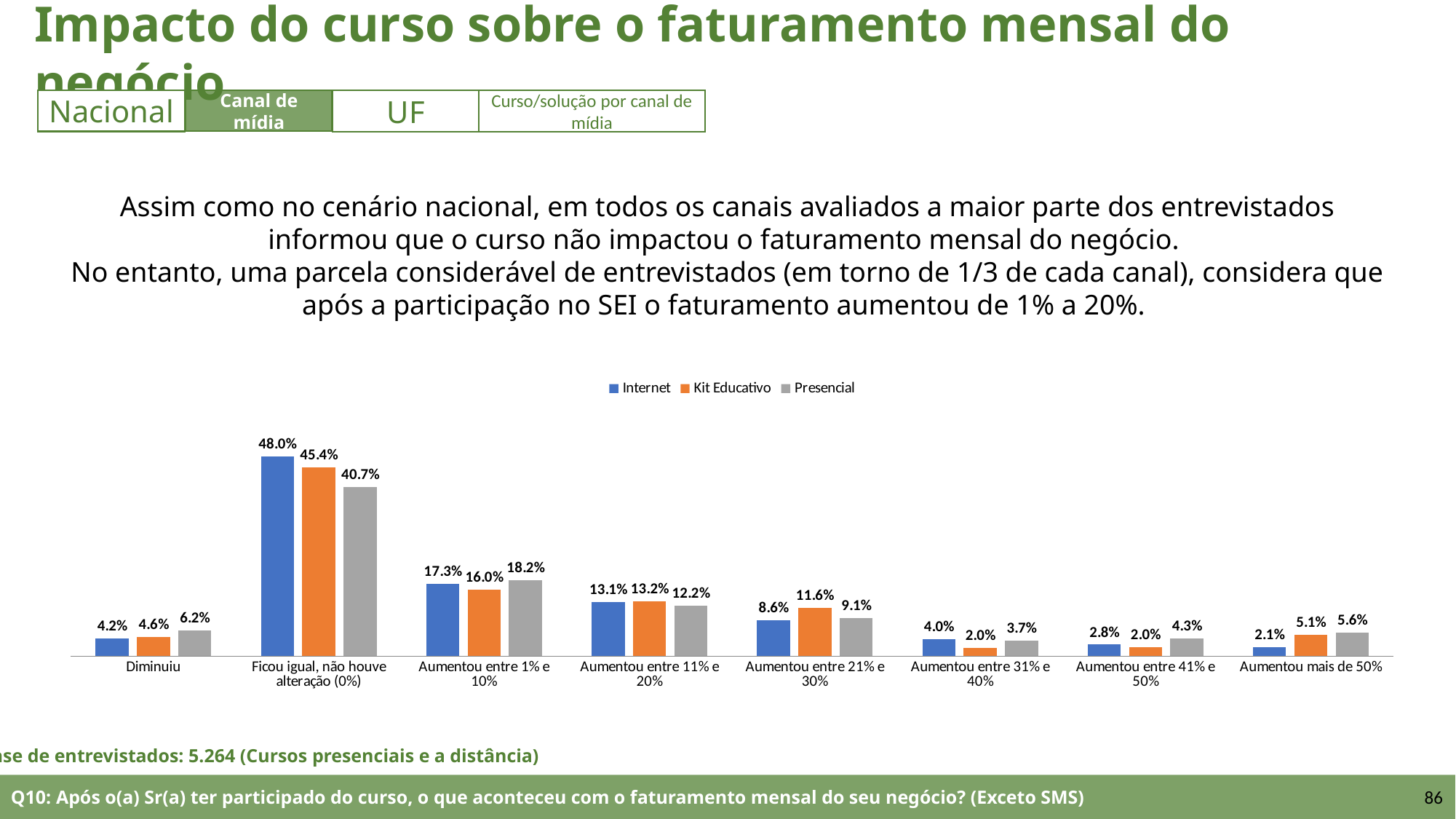
In the category "Aumentou mais de 50%", which series has the larger value, Internet or Kit Educativo? Kit Educativo What is the value for Presencial in the category "Aumentou entre 1% e 10%"? 18.2% Which category has the highest value for the Presencial series? Ficou igual, não houve alteração (0%) How many categories are shown on the x axis? 8 Which series is shown in orange in the legend? Kit Educativo Which category has the lowest value for the Internet series? Aumentou mais de 50% How many series does the legend list? 3 What is the difference between the Internet and Presencial values in the category "Ficou igual, não houve alteração (0%)"? 7.3% In the category "Diminuiu", which series has the larger value, Internet or Presencial? Presencial What is the value for Kit Educativo in the category "Aumentou entre 21% e 30%"? 11.6% What type of chart is shown on the slide? Bar chart What is the value for Internet in the category "Ficou igual, não houve alteração (0%)"? 48.0%